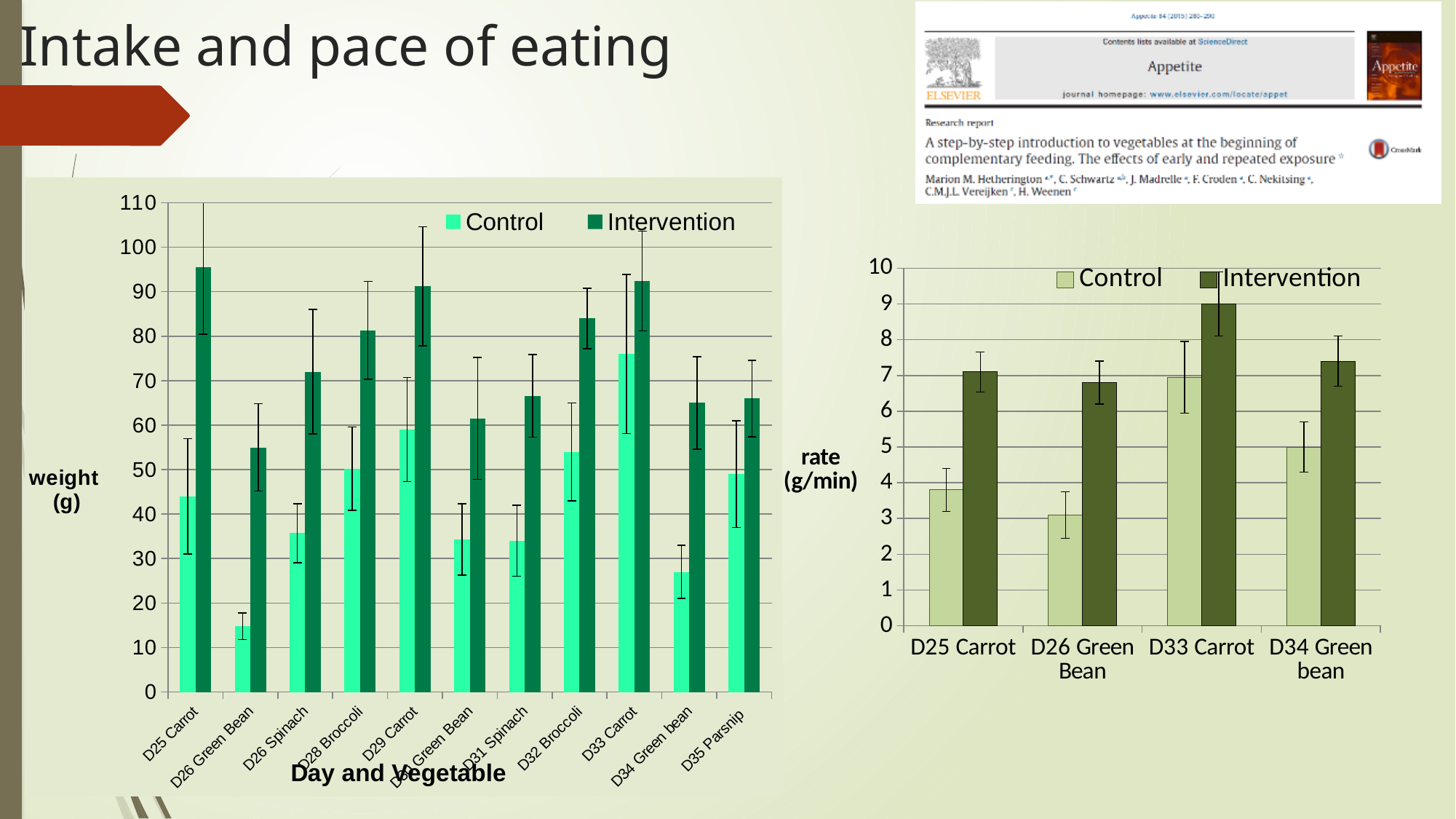
In the right chart (rate in g/min), which category has the highest Intervention value? D33 Carrot In the left chart (weight in g), which category has the lowest Control value? D26 Green Bean In the right chart (rate in g/min), how many categories are shown on the x axis? 4 In the right chart (rate in g/min), which category has the lowest Control value? D26 Green Bean In the left chart (weight in g), how many series does the legend list? 2 In the left chart (weight in g), how many day-and-vegetable categories are shown on the x axis? 11 What kind of chart is the right chart (rate in g/min)? Bar chart In the right chart (rate in g/min), is the Control value for D26 Green Bean greater or less than 4? less In the right chart (rate in g/min), which is larger for D25 Carrot, the Control value or the Intervention value? Intervention In the left chart (weight in g), is the Intervention value for D25 Carrot greater or less than 90? greater In the left chart (weight in g), which category has the highest Control value? D33 Carrot In the left chart (weight in g), which category has the lowest Intervention value? D26 Green Bean